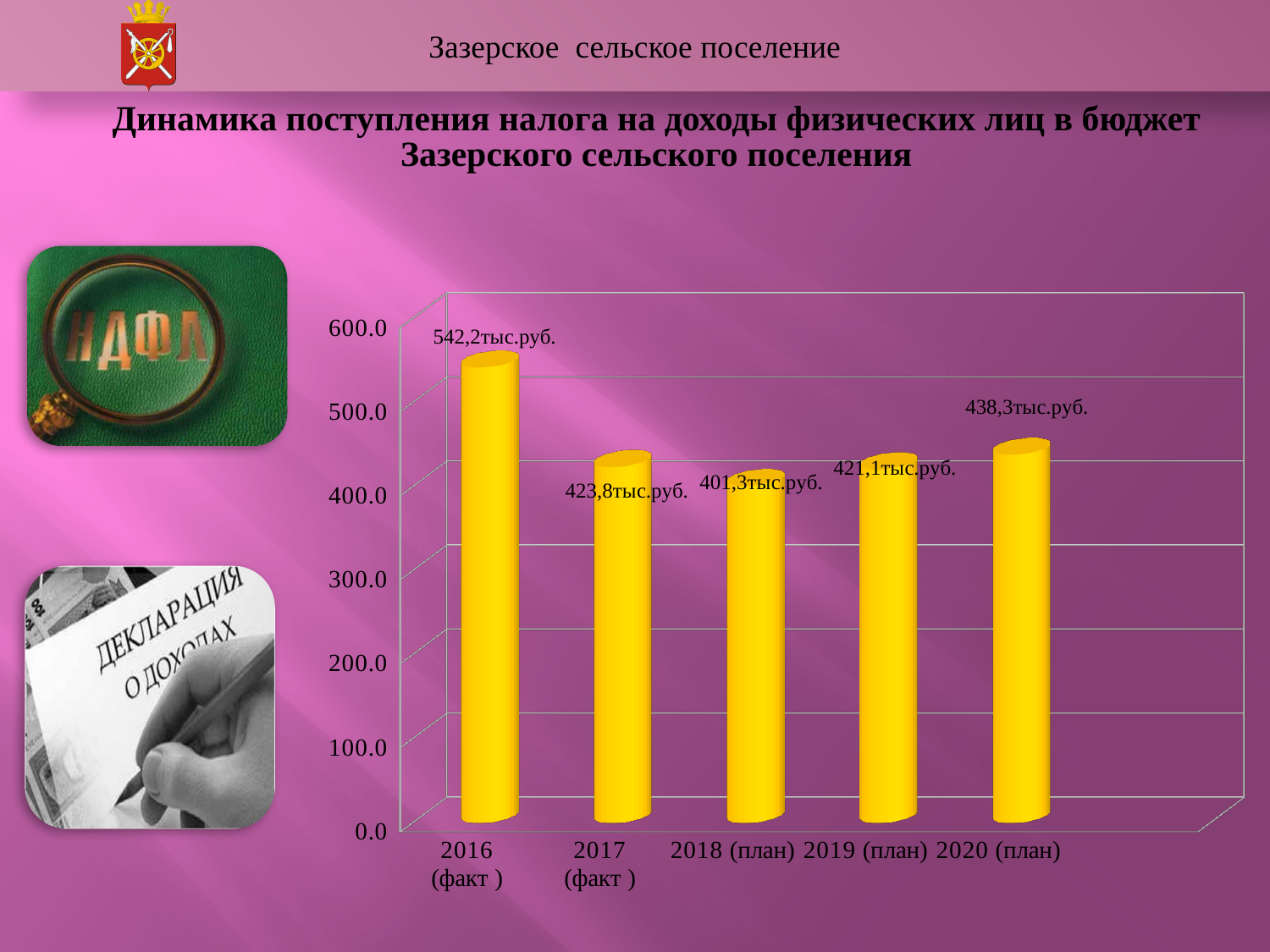
What is the value for 2016 (факт)? 542,2тыс.руб. What is the value for 2020 (план)? 438,3тыс.руб. Which year has the highest value? 2016 (факт) How many years are shown on the x axis? 5 What is the difference between the values for 2016 (факт) and 2017 (факт)? 118,4тыс.руб. Which is larger, the value for 2020 (план) or the value for 2018 (план)? 2020 (план) Which year has the lowest value? 2018 (план) What is the value for 2018 (план)? 401,3тыс.руб. Do the values rise or fall from 2018 (план) to 2020 (план)? rise Is the value for 2016 (факт) greater or less than 500.0? greater What kind of chart is shown on the slide? bar chart What is the difference between the values for 2020 (план) and 2018 (план)? 37,0тыс.руб.